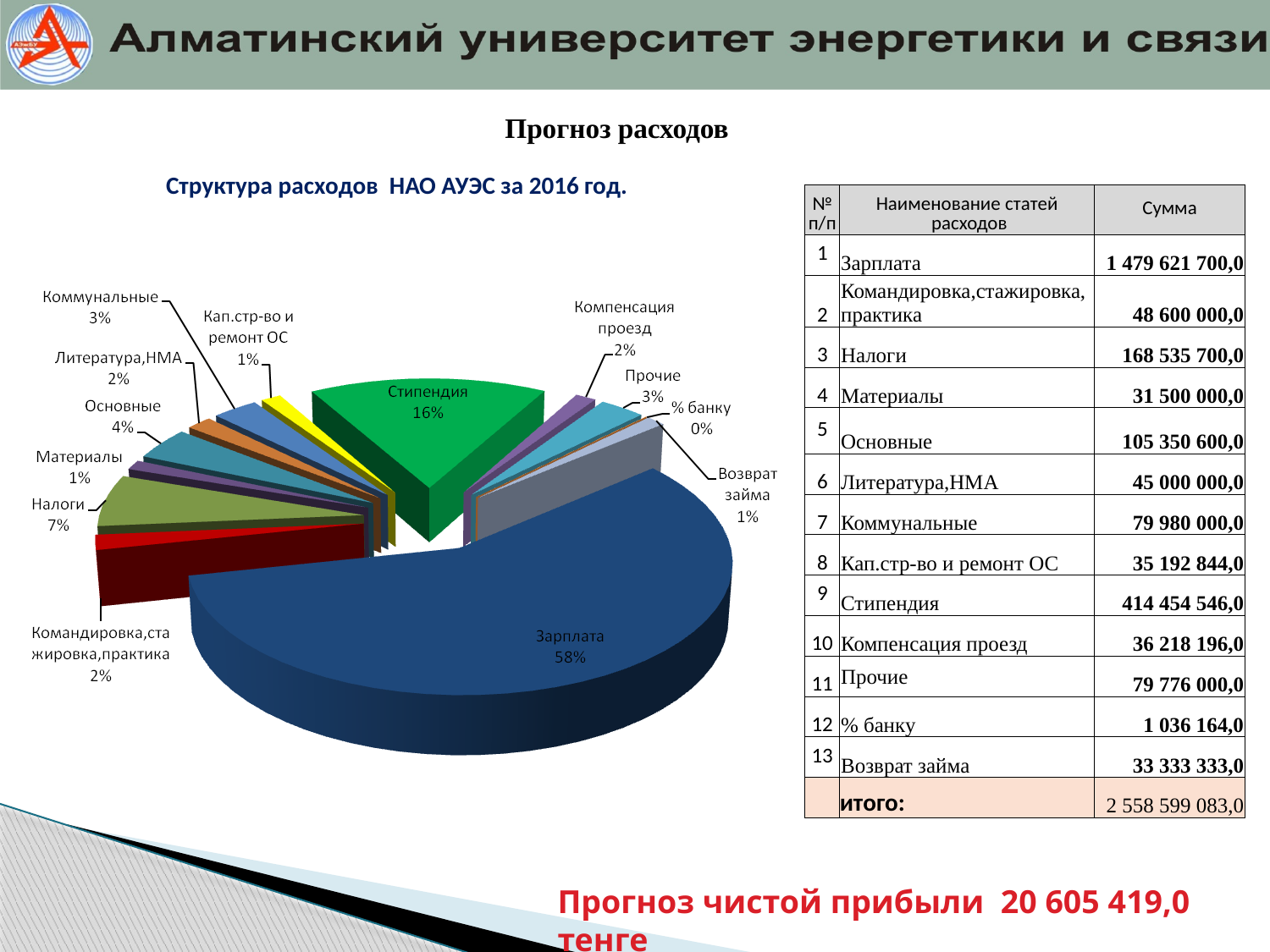
What share of expenses does Зарплата account for in the pie chart? 58% How many slices does the pie chart have? 13 What percentage is shown for Налоги in the pie chart? 7% What is the difference in percentage points between Зарплата and Стипендия in the pie chart? 42 What percentage is shown for Основные in the pie chart? 4% Which category has the largest share in the pie chart? Зарплата What percentage is shown for Стипендия in the pie chart? 16% Which category has the smallest share in the pie chart? % банку What percentage is shown for % банку in the pie chart? 0% What type of chart is shown on the slide? pie chart What is the title of the pie chart? Структура расходов НАО АУЭС за 2016 год. Which has a larger share in the pie chart, Налоги or Коммунальные? Налоги